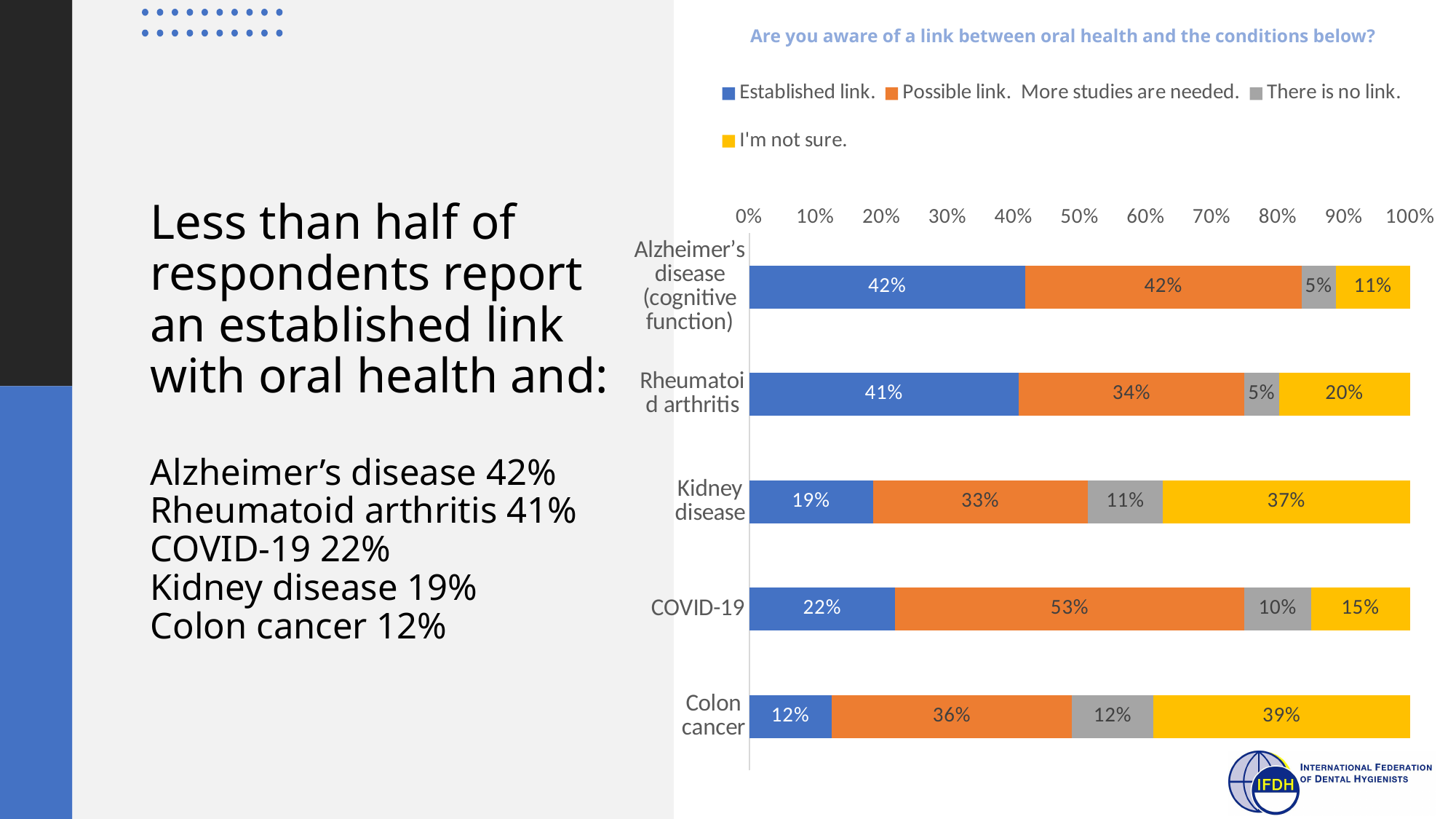
Which condition has the highest 'Established link' percentage? Alzheimer's disease (cognitive function) What type of chart is shown on the slide? Stacked bar chart What is the total of the Rheumatoid arthritis bar? 100% What is the 'I'm not sure' value for Kidney disease? 37% What is the title of the chart? Are you aware of a link between oral health and the conditions below? How many conditions are shown on the chart? 5 How many series does the legend list? 4 What is the 'Possible link. More studies are needed.' value for Colon cancer? 36% What is the difference between the 'Possible link' values for COVID-19 and Rheumatoid arthritis? 19% Which condition has the lowest 'Established link' percentage? Colon cancer What percentage of respondents reported an established link between oral health and COVID-19? 22% Which is larger: the 'I'm not sure' value for Colon cancer or for Kidney disease? Colon cancer